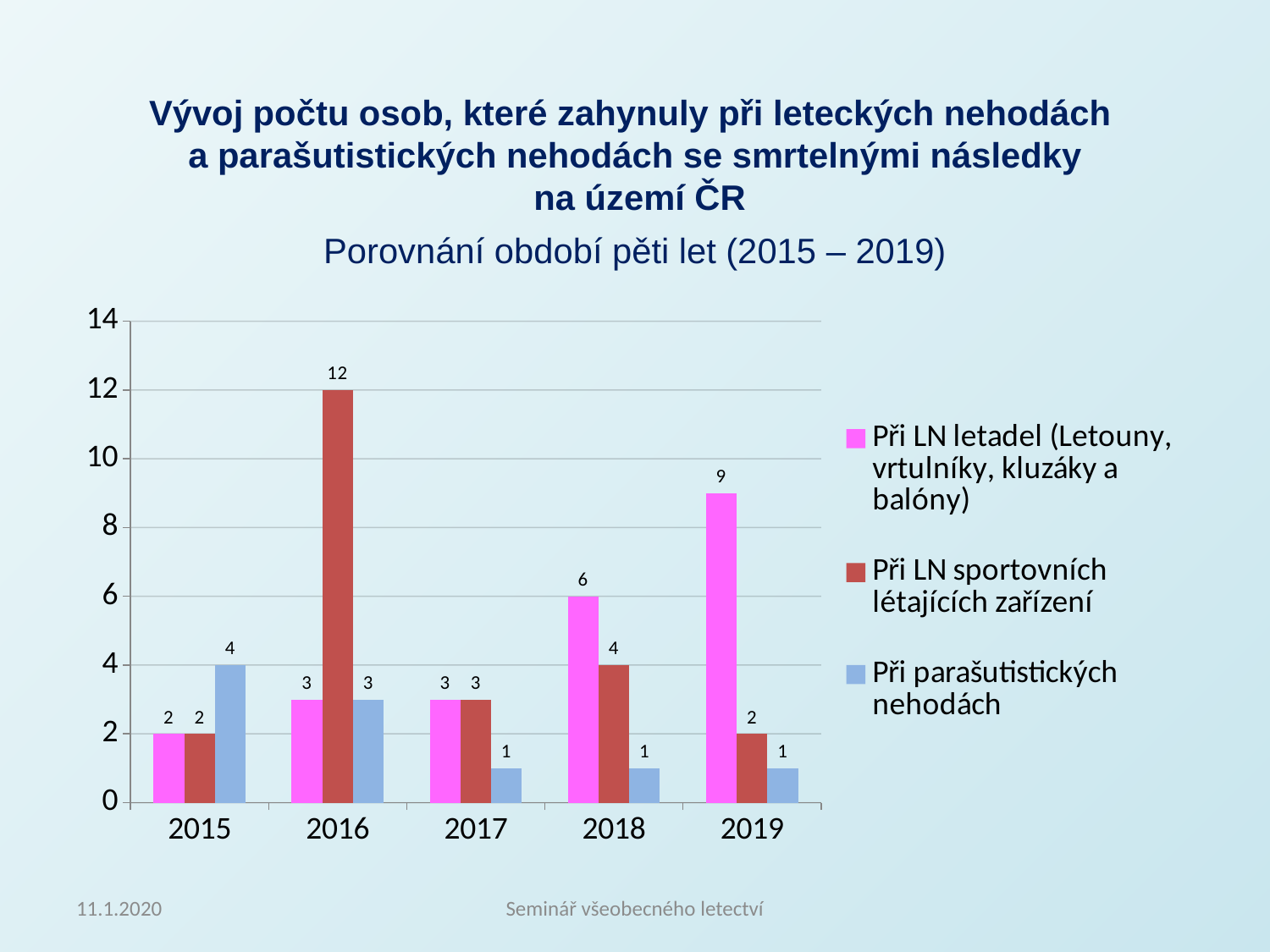
Which is larger in 2018: 'Při LN letadel (Letouny, vrtulníky, kluzáky a balóny)' or 'Při LN sportovních létajících zařízení'? Při LN letadel (Letouny, vrtulníky, kluzáky a balóny) What colour represents 'Při parašutistických nehodách' in the chart? light blue Is the value for 'Při LN sportovních létajících zařízení' in 2016 greater or less than 10? greater What is the value for 'Při LN sportovních létajících zařízení' in 2016? 12 What is the value for 'Při parašutistických nehodách' in 2015? 4 How many years are shown on the x axis? 5 In which year is the value for 'Při LN letadel (Letouny, vrtulníky, kluzáky a balóny)' highest? 2019 What is the difference between the 'Při LN sportovních létajících zařízení' value in 2016 and in 2017? 9 In which year is the value for 'Při LN sportovních létajících zařízení' lowest? 2015 and 2019 (both 2) What kind of chart is shown on the slide? bar chart What is the value for 'Při LN letadel (Letouny, vrtulníky, kluzáky a balóny)' in 2019? 9 How many series does the legend list? 3